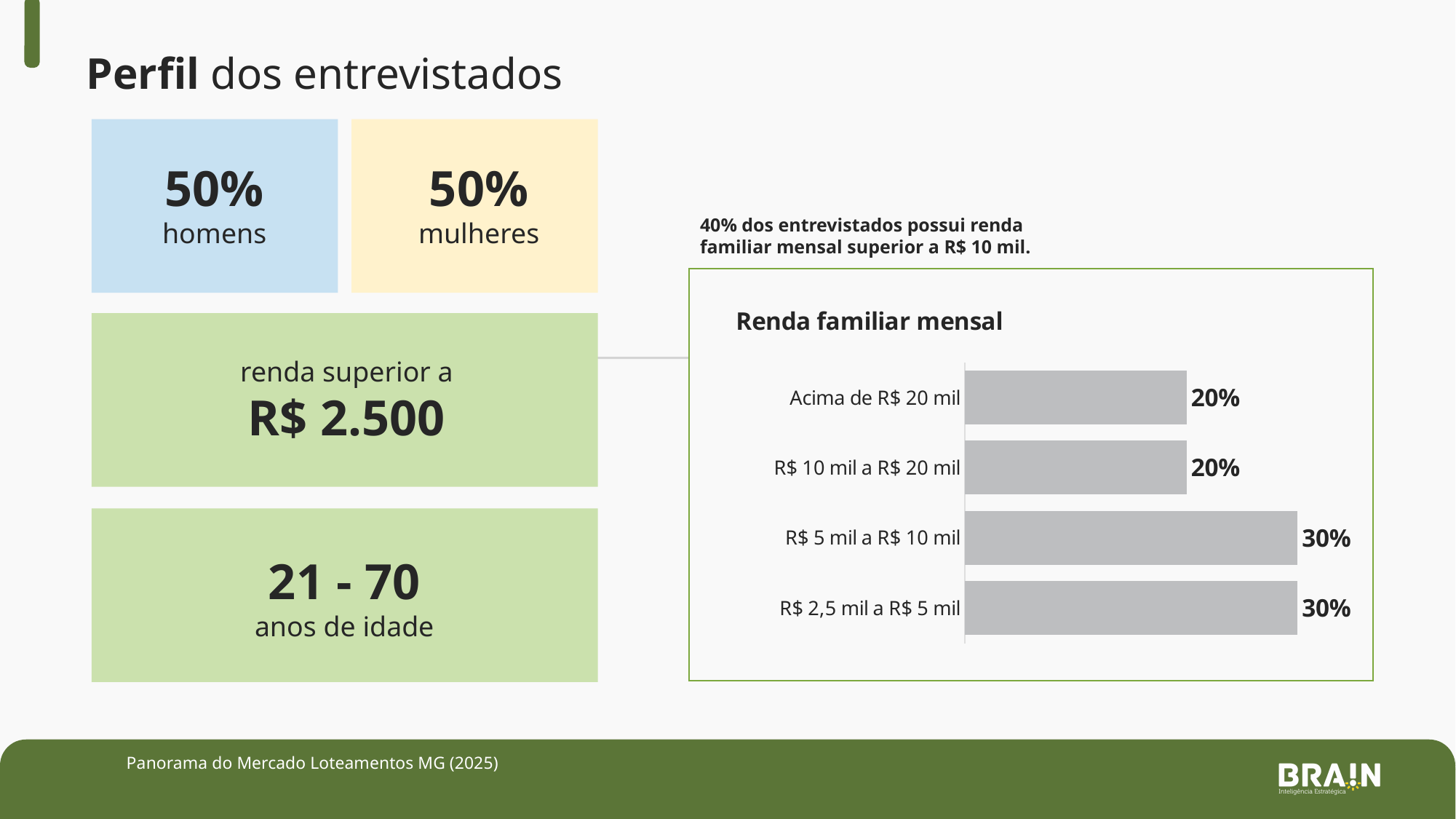
In the 'Renda familiar mensal' chart, what is the combined value of 'Acima de R$ 20 mil' and 'R$ 10 mil a R$ 20 mil'? 40% How many categories does the 'Renda familiar mensal' chart show? 4 What is the value for 'R$ 2,5 mil a R$ 5 mil' in the 'Renda familiar mensal' chart? 30% What is the value for 'Acima de R$ 20 mil' in the 'Renda familiar mensal' chart? 20% In the 'Renda familiar mensal' chart, which is larger: 'R$ 2,5 mil a R$ 5 mil' or 'R$ 10 mil a R$ 20 mil'? R$ 2,5 mil a R$ 5 mil What colour are the bars in the 'Renda familiar mensal' chart? Grey What kind of chart is 'Renda familiar mensal'? Bar chart What is the value for 'R$ 10 mil a R$ 20 mil' in the 'Renda familiar mensal' chart? 20% What is the value for 'R$ 5 mil a R$ 10 mil' in the 'Renda familiar mensal' chart? 30% In the 'Renda familiar mensal' chart, what is the difference between 'R$ 5 mil a R$ 10 mil' and 'Acima de R$ 20 mil'? 10% What is the title of the chart on the slide? Renda familiar mensal